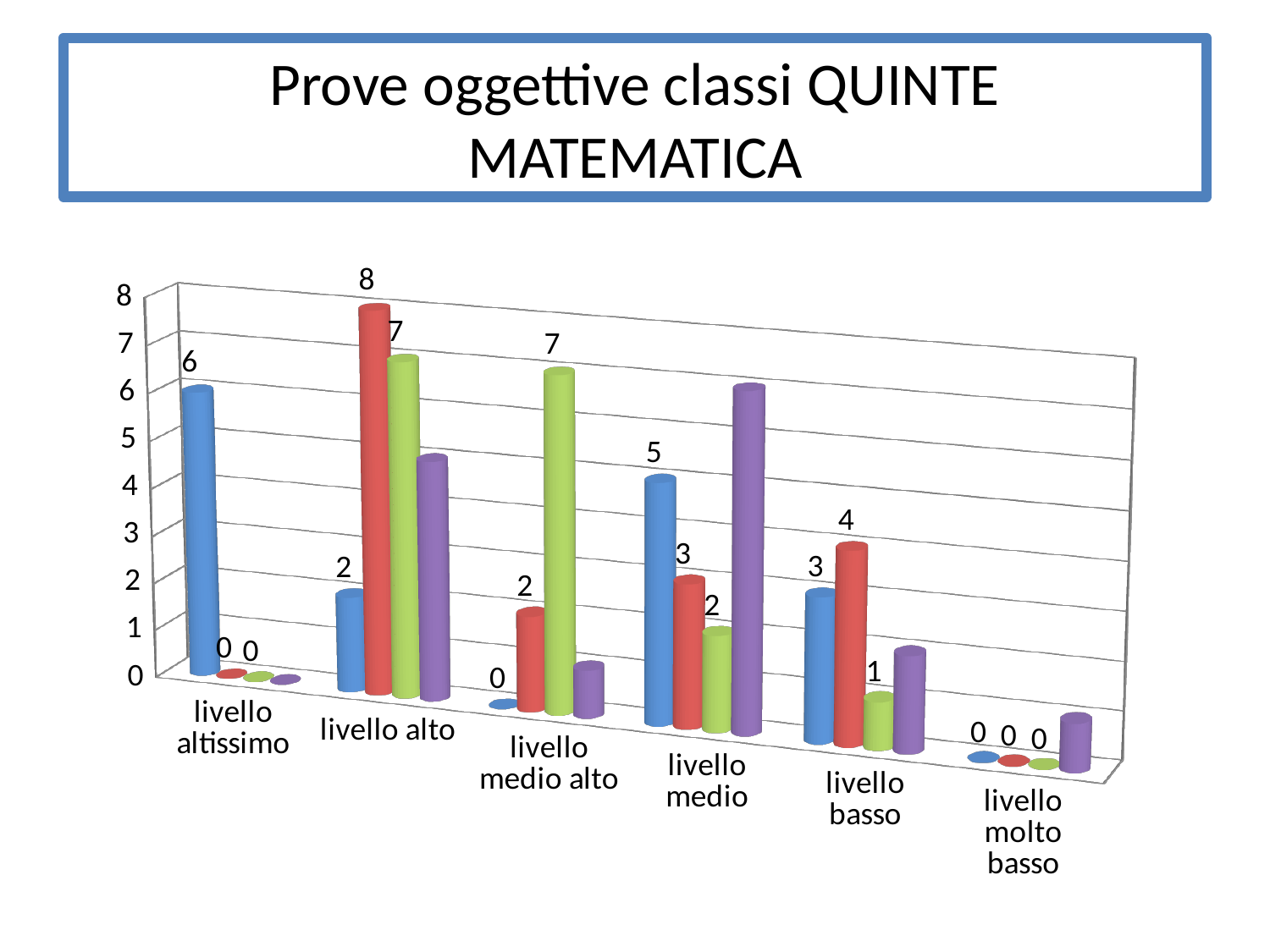
Which category has the highest value for the red series? livello alto What is the value of the red bar for 'livello alto'? 8 Which is larger for 'livello basso': the red bar or the blue bar? the red bar How many categories are shown along the x axis of the chart? 6 What is the value of the green bar for 'livello basso'? 1 What is the difference between the red bar and the blue bar for 'livello alto'? 6 What type of chart is shown on the slide? bar chart What is the title of the slide containing the chart? Prove oggettive classi QUINTE MATEMATICA What is the value of the blue bar for 'livello medio'? 5 Is the value of the purple bar for 'livello medio' greater or less than 4? greater What is the value of the green bar for 'livello medio alto'? 7 What is the value of the blue bar for 'livello altissimo'? 6